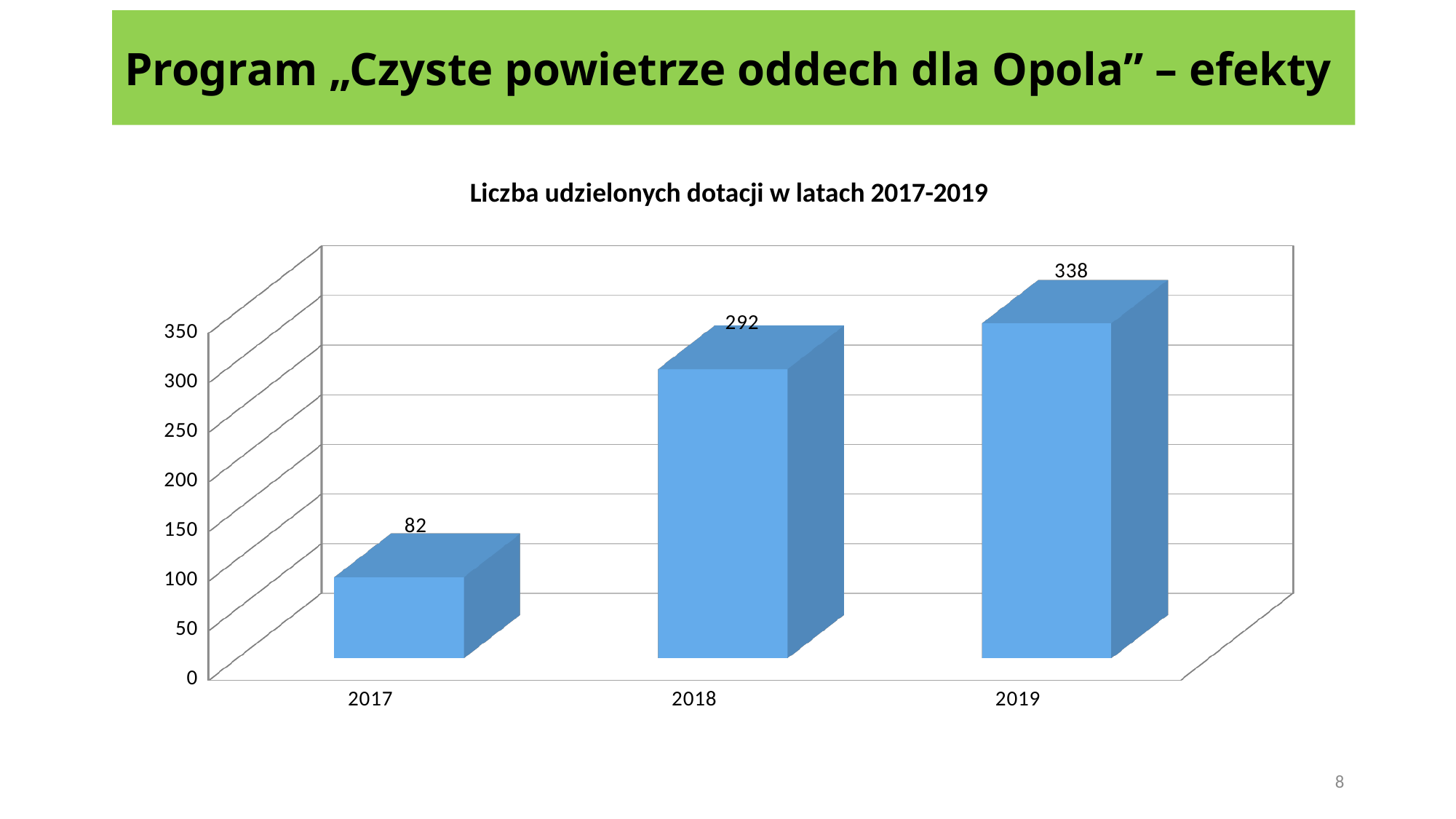
What is the value for 2019? 338 How many years are shown on the x axis? 3 Which year has the lowest value? 2017 What is the difference between the values for 2018 and 2017? 210 Which year has the highest value? 2019 Which is larger, the value for 2017 or the value for 2018? 2018 Is the value for 2017 greater or less than 100? less What is the value for 2018? 292 What is the value for 2017? 82 What is the difference between the values for 2019 and 2018? 46 What kind of chart is shown on the slide? bar chart Do the values rise or fall from 2017 to 2019? rise